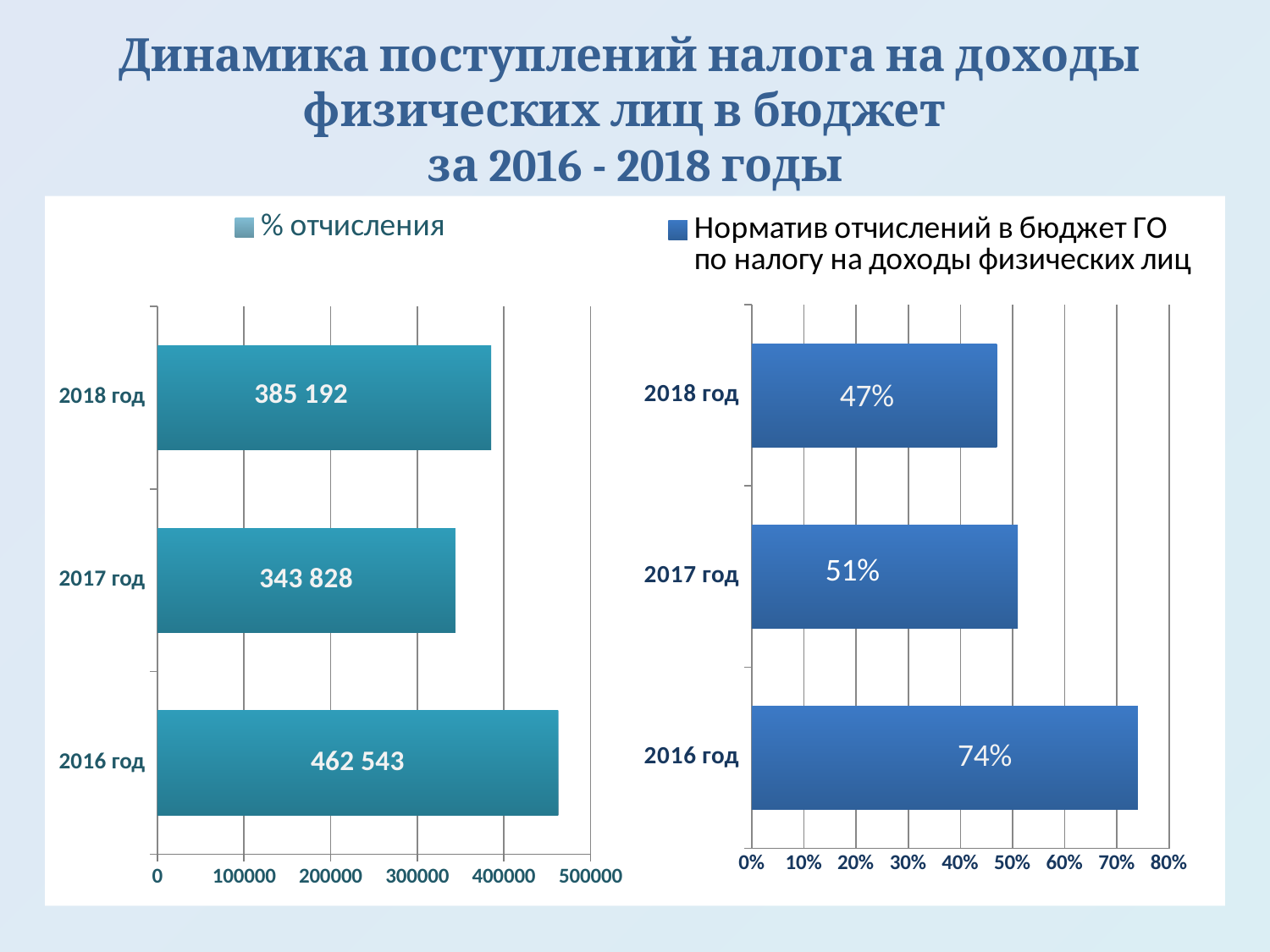
In the right chart, which year has the lowest value? 2018 год In the left chart, which year has the lowest value? 2017 год In the left chart, what is the difference between the values for 2016 год and 2018 год? 77 351 In the right chart, what is the value for 2018 год? 47% In the left chart, what is the value for 2016 год? 462 543 In the right chart, which is larger: the value for 2017 год or 2018 год? 2017 год In the left chart, which year has the highest value? 2016 год What kind of chart is the right chart? bar chart In the left chart, what is the value for 2017 год? 343 828 How many years are shown in the left chart? 3 In the right chart, what is the value for 2016 год? 74% In the right chart, what is the difference between the values for 2016 год and 2017 год? 23%